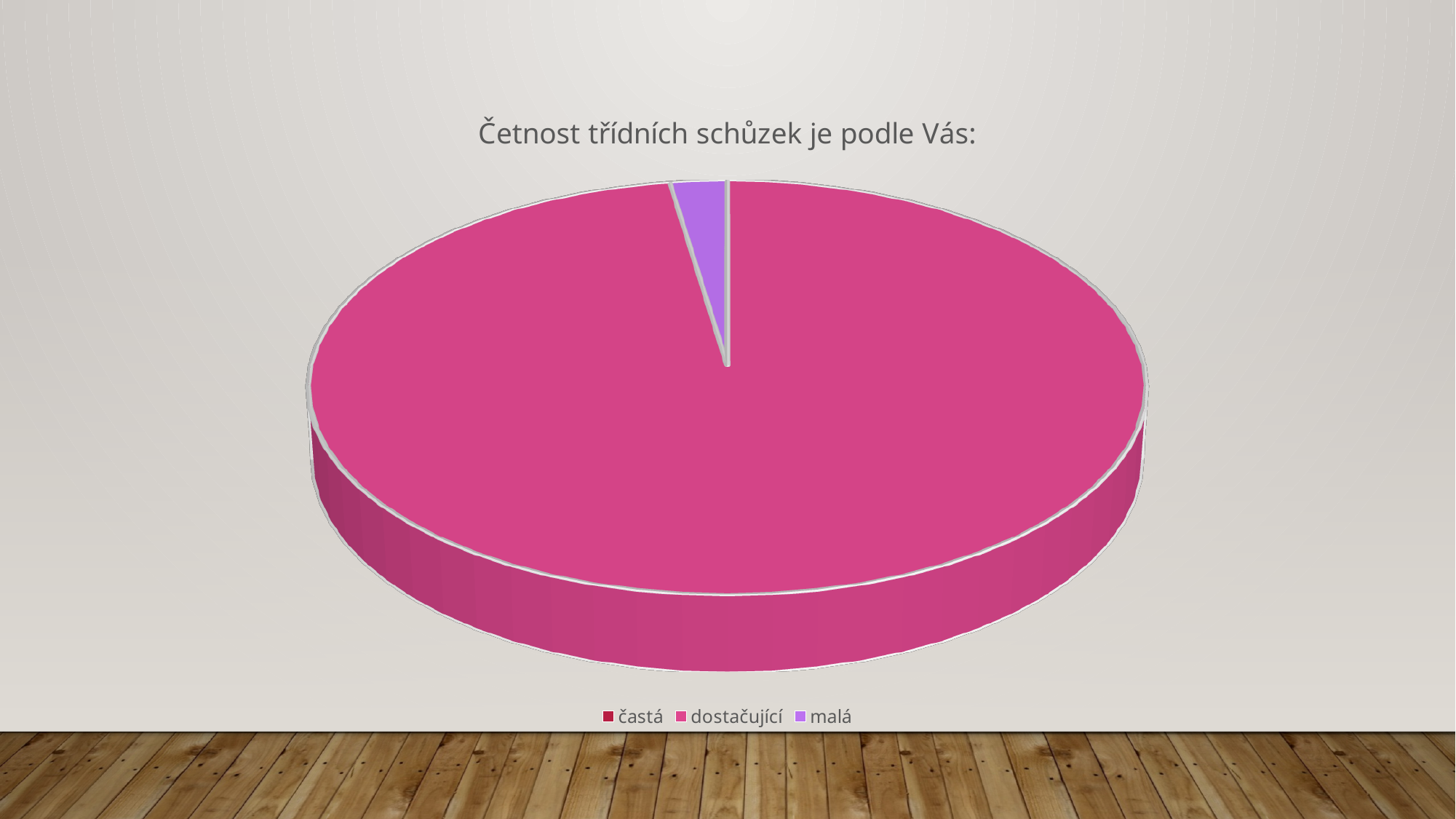
How many entries does the chart legend list? 3 What is the title of the chart? Četnost třídních schůzek je podle Vás: Which category has the largest share of the pie? dostačující Does the slice for malá take up more or less than a quarter of the pie? less Which is larger, the slice for dostačující or the slice for malá? dostačující Does the slice for dostačující take up more or less than half of the pie? more What kind of chart is shown on the slide? pie chart Which colour represents the category malá in the chart? purple